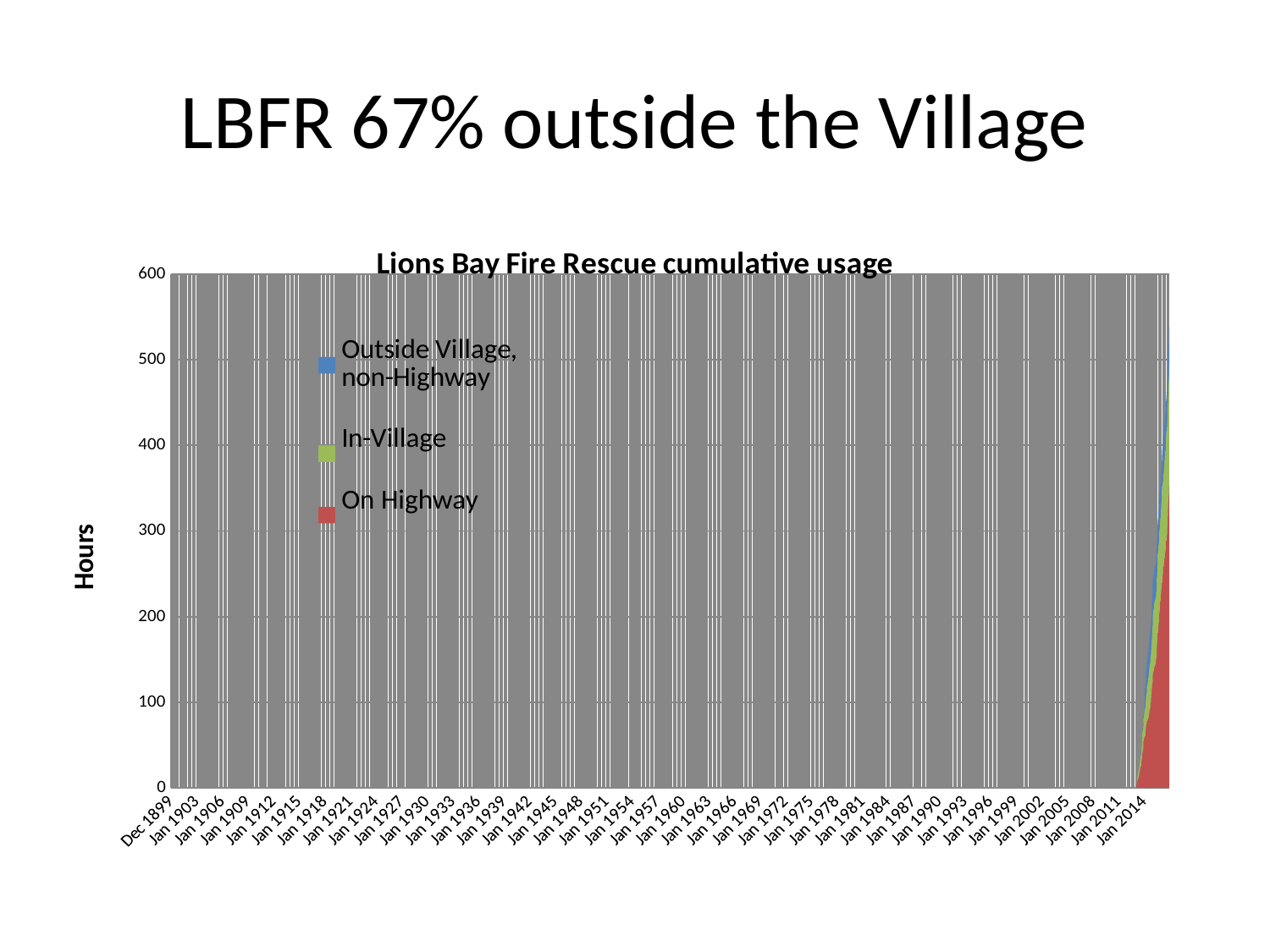
What is the last labelled year on the x axis of the chart? Jan 2014 What is the highest value shown on the vertical axis of the chart? 600 What is the label on the vertical axis of the chart? Hours At the right end of the chart, is the On Highway area larger or smaller than the In-Village area? Larger Do the cumulative hours rise or fall toward the right end of the x axis? Rise What kind of chart is shown on the slide? Stacked area chart Which series accounts for the largest share of hours at the right end of the chart? On Highway Which series accounts for the smallest share of hours at the right end of the chart? Outside Village, non-Highway How many series does the chart's legend list? 3